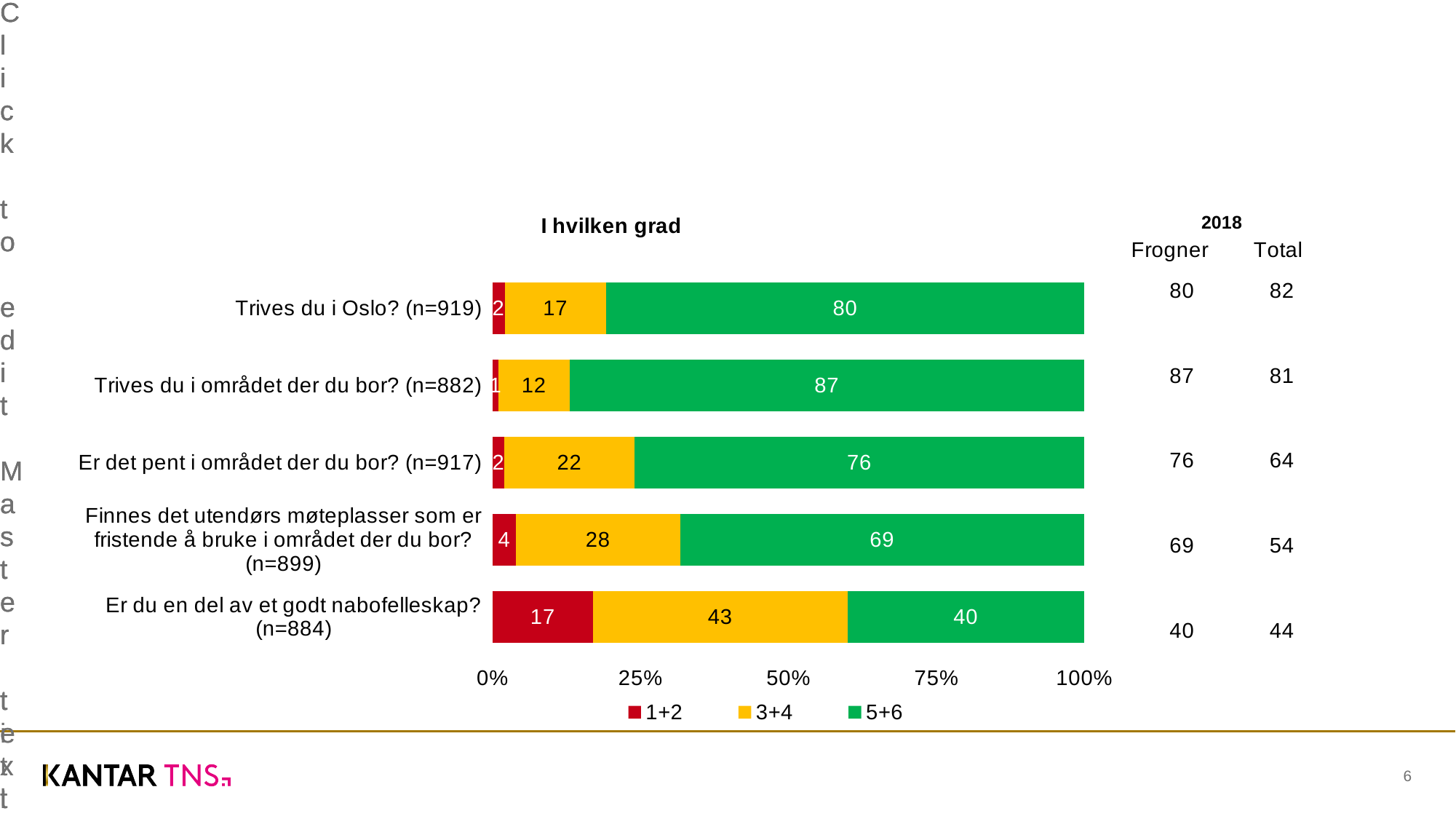
What is the 3+4 value for "Er det pent i området der du bor? (n=917)"? 22 What is the 1+2 value for "Er du en del av et godt nabofelleskap? (n=884)"? 17 Which category has the highest 5+6 value? Trives du i området der du bor? (n=882) Which category has the lowest 5+6 value? Er du en del av et godt nabofelleskap? (n=884) What is the total of the stacked bar for "Er det pent i området der du bor? (n=917)"? 100 What is the difference between the 5+6 values for "Trives du i Oslo? (n=919)" and "Finnes det utendørs møteplasser som er fristende å bruke i området der du bor? (n=899)"? 11 What is the title of the chart? I hvilken grad What kind of chart is shown on the slide? Stacked bar chart How many series does the legend list? 3 What is the 5+6 value for "Trives du i området der du bor? (n=882)"? 87 Which is larger: the 3+4 value for "Er du en del av et godt nabofelleskap? (n=884)" or the 3+4 value for "Finnes det utendørs møteplasser som er fristende å bruke i området der du bor? (n=899)"? Er du en del av et godt nabofelleskap? (n=884) How many questions (categories) are plotted in the chart? 5